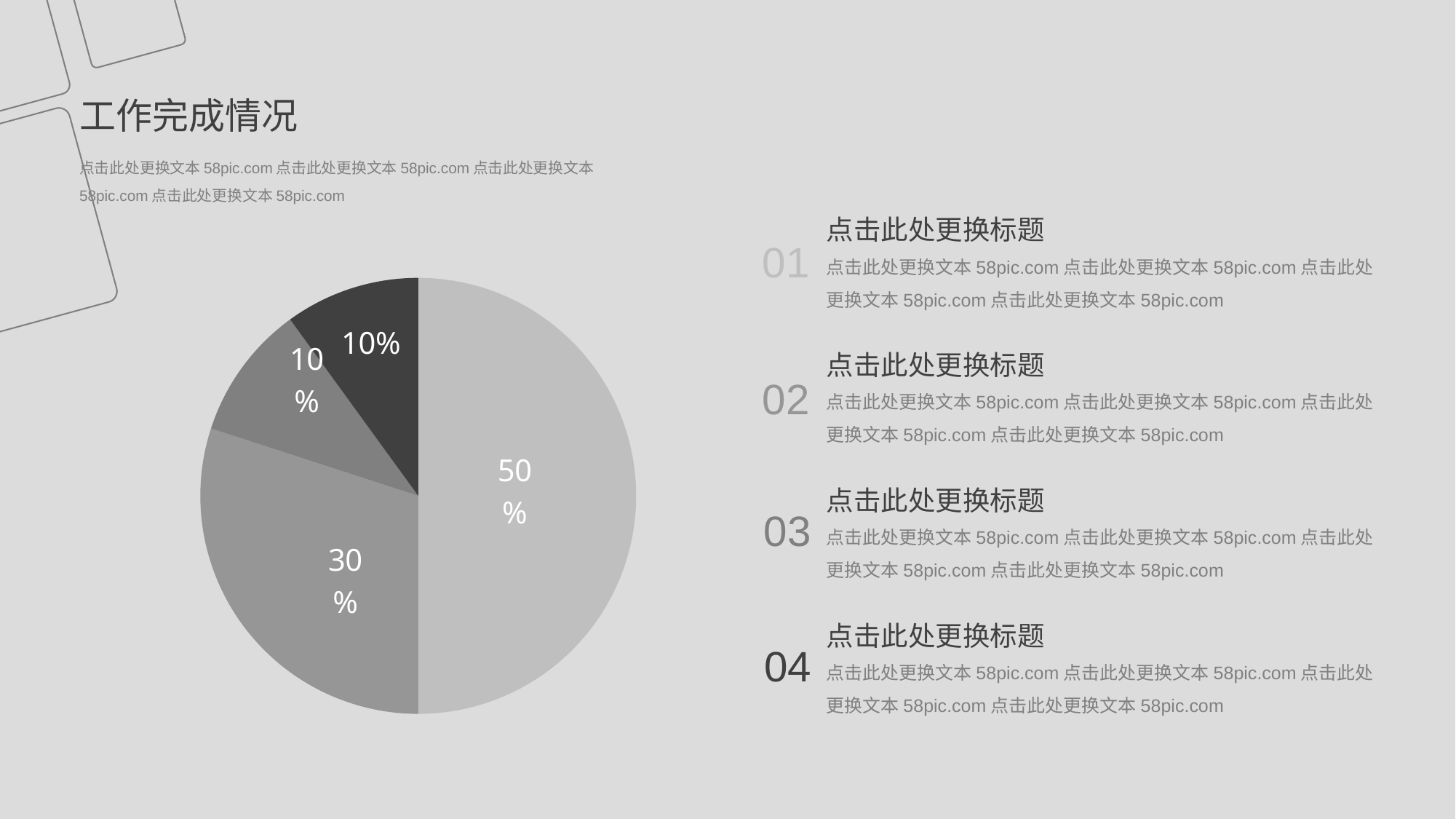
How many slices of the pie chart are labelled 10%? 2 What value is labelled on the light grey slice on the right half of the pie chart? 50% What value is labelled on the darkest (near-black) slice of the pie chart? 10% What value is labelled on the slice in the lower-left part of the pie chart? 30% What is the difference between the largest slice (50%) and the 30% slice? 20 percentage points What is the value of the largest slice of the pie chart? 50% What is the value of the smallest slice of the pie chart? 10% How many slices does the pie chart have? 4 What is the title of the slide containing the pie chart? 工作完成情况 What kind of chart is shown on the slide? pie chart What do the four slice values of the pie chart add up to? 100% Which is larger: the slice on the right half of the pie or the slice in the lower-left? the slice on the right half (50%)